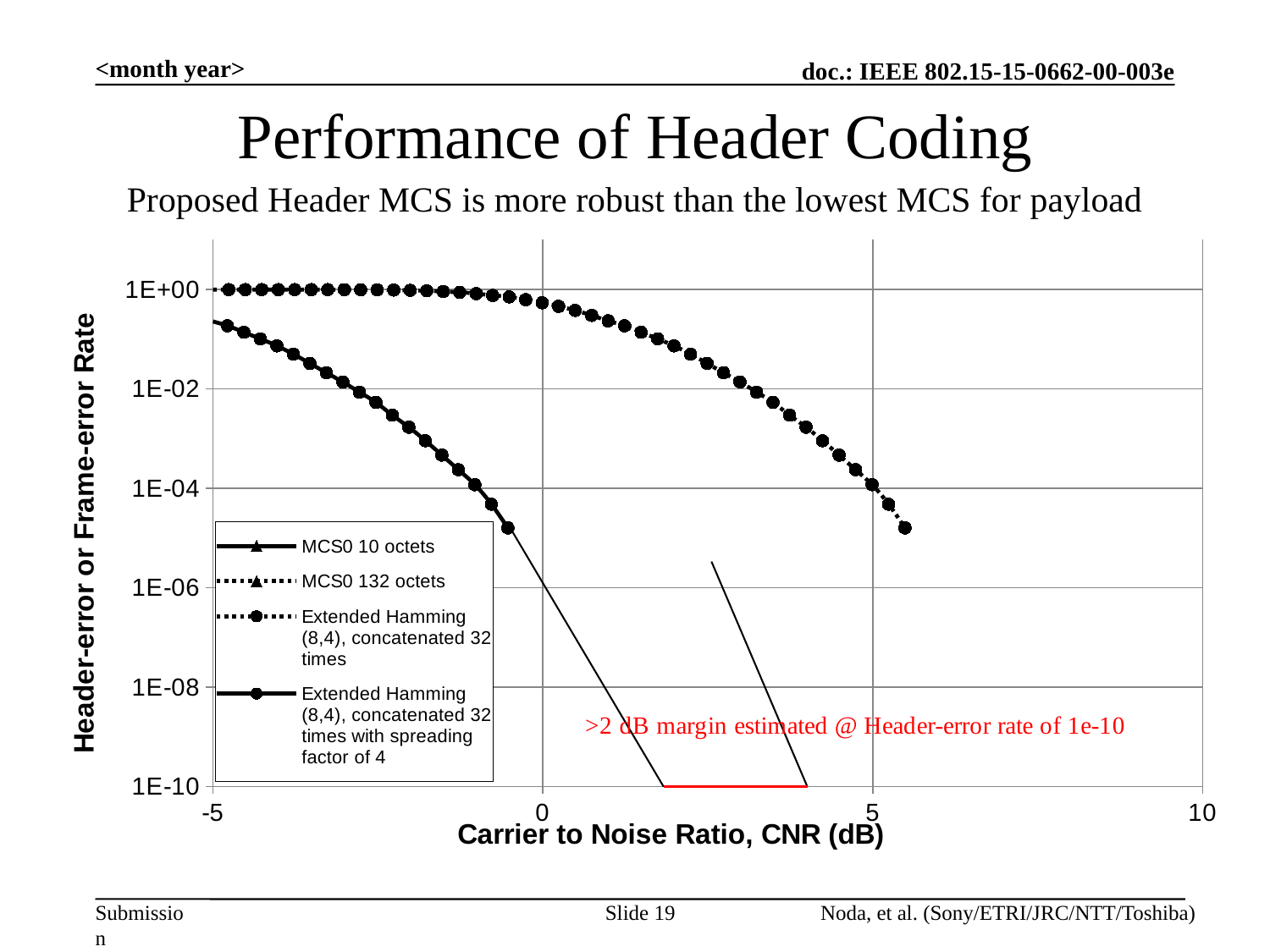
How many series does the legend list? 4 What kind of chart is shown on the slide? Line chart What is the title of the x axis? Carrier to Noise Ratio, CNR (dB) What is the highest value shown on the x axis? 10 Is the value of the upper (dotted) curve at CNR 2.5 dB greater or less than 1E-04? greater Is the value of the lower (solid) curve at CNR 0 dB greater or less than 1E-04? less Is the value of the lower (solid) curve at CNR -5 dB greater or less than 1E-02? greater At CNR 0 dB, which curve has the higher error rate, the dotted curve or the solid curve? The dotted curve What is the title of the y axis? Header-error or Frame-error Rate What is the lowest value shown on the y axis? 1E-10 Do the error-rate curves rise or fall as the Carrier to Noise Ratio increases? Fall